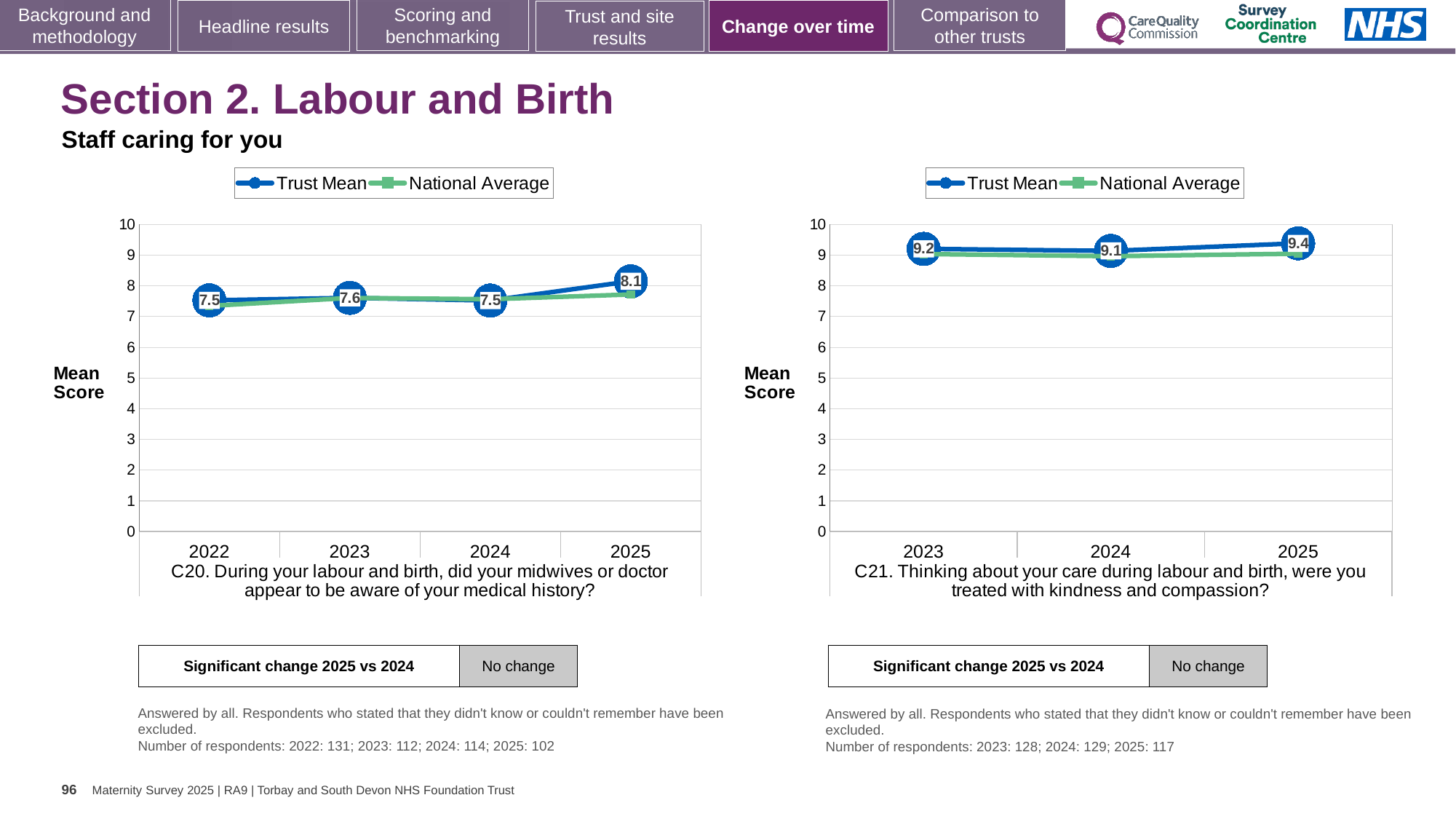
In the C21 chart (right), what is the Trust Mean for 2024? 9.1 What kind of chart is the C21 chart (right)? line chart In the C20 chart (left), is the National Average for 2022 greater or less than 8? less In the C20 chart (left), which year has the highest Trust Mean? 2025 How many series does the legend of the C21 chart (right) list? 2 In the C21 chart (right), which year has the highest Trust Mean? 2025 How many years are plotted on the x axis of the C20 chart (left)? 4 In the C20 chart (left), what is the difference between the Trust Mean for 2025 and the Trust Mean for 2024? 0.6 In the C21 chart (right), is the Trust Mean for 2023 larger or smaller than the Trust Mean for 2025? smaller In the C20 chart (left), what is the Trust Mean for 2023? 7.6 In the C20 chart (left), what is the Trust Mean for 2025? 8.1 In the C21 chart (right), which year has the lowest Trust Mean? 2024